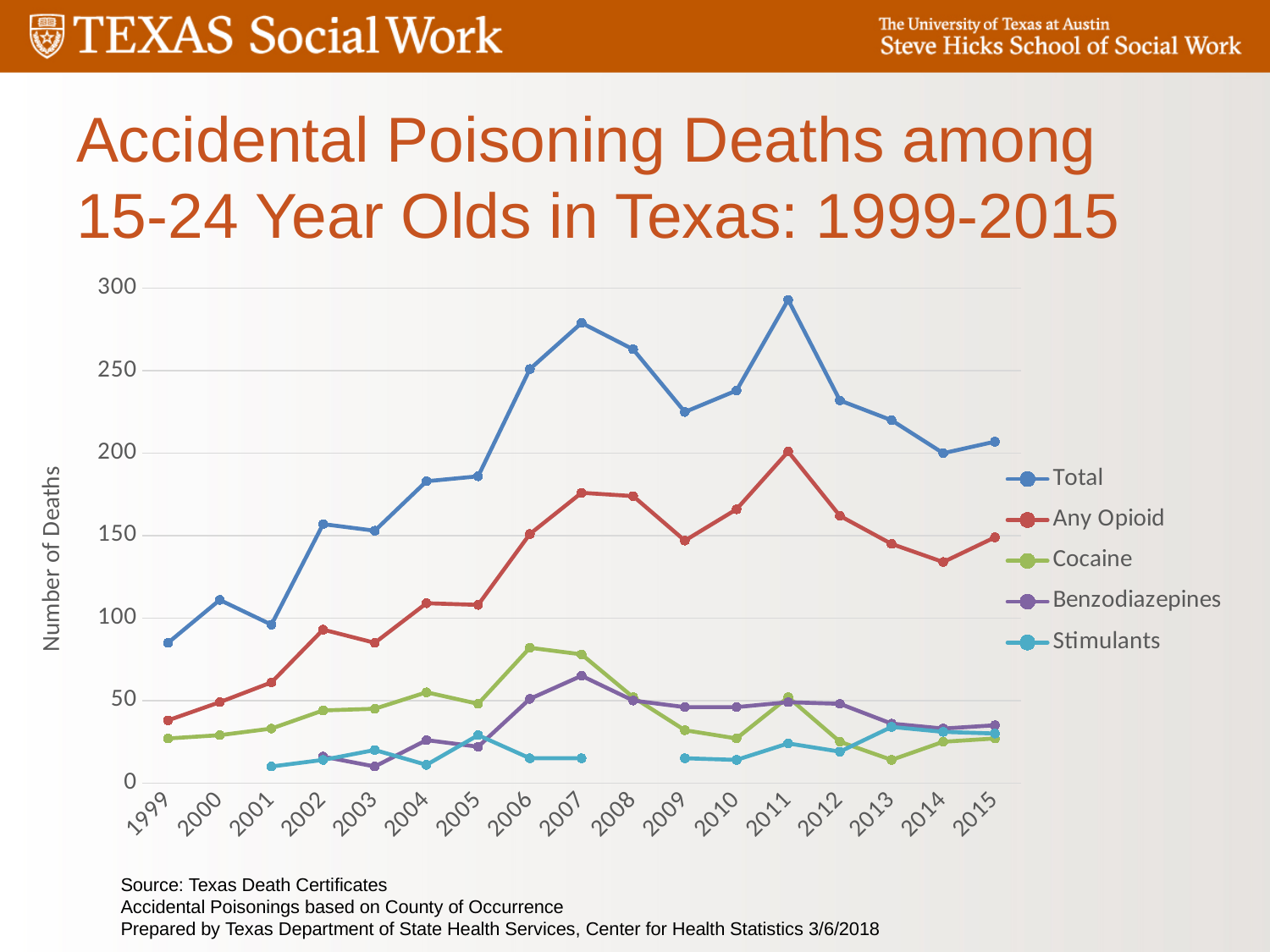
In which year does the Cocaine series reach its highest value? 2006 In which year does the Any Opioid series reach its highest value? 2011 What kind of chart is shown on the slide? Line chart How many years are shown on the x axis? 17 In which year is the Total series at its lowest value? 1999 Is the value for Total in 2011 greater or less than 250? greater What is the label on the y axis? Number of Deaths Is the value for Total in 1999 greater or less than 100? less Which series is higher in 2007, Cocaine or Benzodiazepines? Cocaine How many series does the legend list? 5 In which year does the Total series reach its highest value? 2011 Is the value for Any Opioid in 2007 greater or less than 150? greater